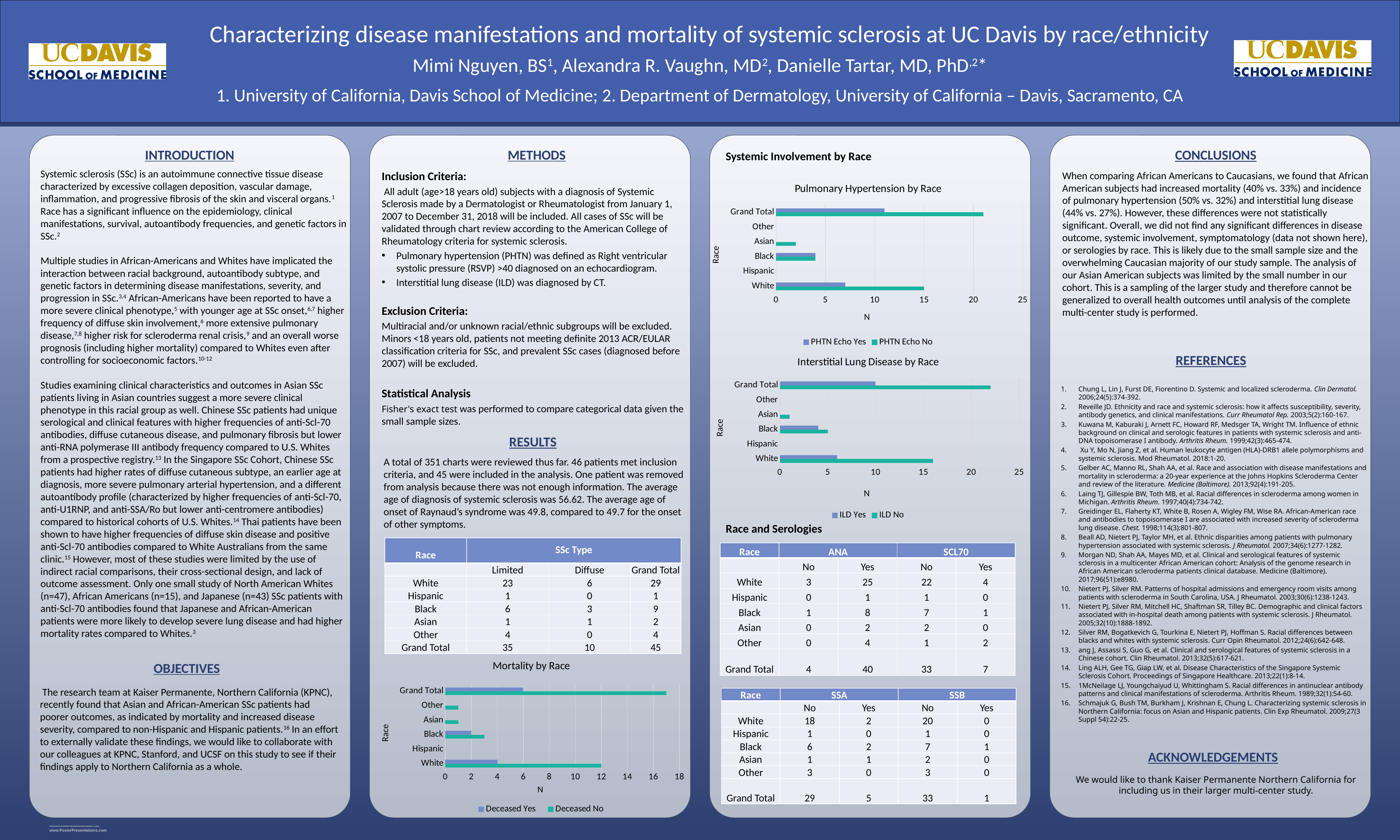
In the 'Pulmonary Hypertension by Race' chart, is the PHTN Echo No value for Grand Total greater or less than 15? greater In the 'Interstitial Lung Disease by Race' chart, is the ILD No value for Grand Total greater or less than 20? greater In the 'Interstitial Lung Disease by Race' chart, is the ILD Yes value for White greater or less than 10? less In the 'Pulmonary Hypertension by Race' chart, which is larger for White: PHTN Echo Yes or PHTN Echo No? PHTN Echo No What kind of chart is the 'Pulmonary Hypertension by Race' chart? bar chart How many series does the legend of the 'Mortality by Race' chart list? 2 What are the two legend entries of the 'Interstitial Lung Disease by Race' chart? ILD Yes and ILD No In the 'Mortality by Race' chart, which individual race (excluding Grand Total) has the highest Deceased No value? White How many race categories are shown on the y axis of the 'Pulmonary Hypertension by Race' chart? 6